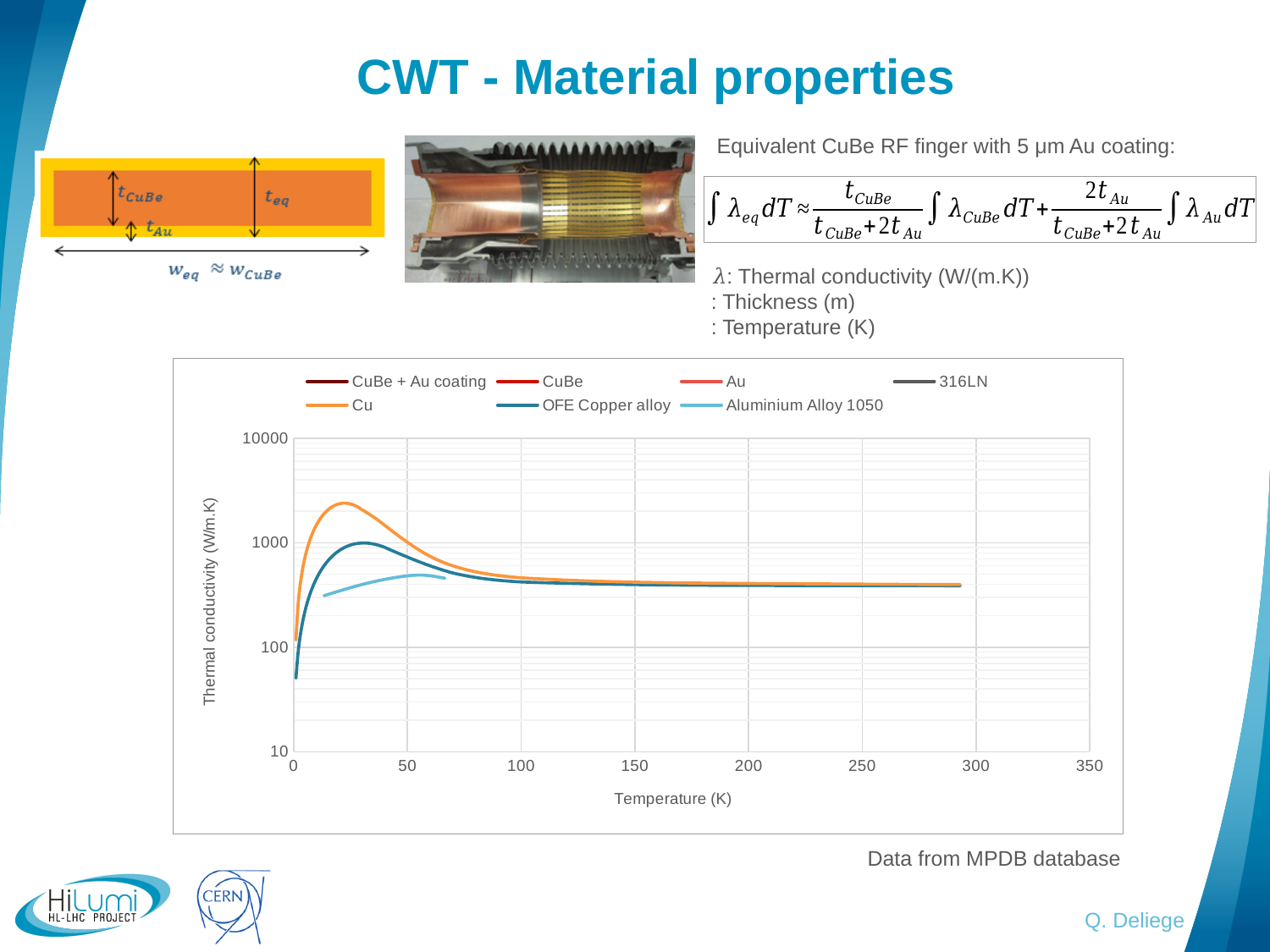
What is the highest tick value shown on the chart's x axis? 350 Is the thermal conductivity of the OFE Copper alloy series at 300 K greater or less than 1000 W/m.K? less What kind of chart is shown on the slide? line chart Is the value of the Cu series at 250 K greater or less than 100 W/m.K? greater What is the label of the chart's y axis? Thermal conductivity (W/m.K) Does the Cu series rise or fall between 50 K and 150 K? fall Which series reaches the highest thermal conductivity on the chart? Cu How many series does the chart legend list? 7 What is the label of the chart's x axis? Temperature (K) At 50 K, which series has the larger thermal conductivity, Cu or Aluminium Alloy 1050? Cu Is the peak value of the Aluminium Alloy 1050 series greater or less than 1000 W/m.K? less